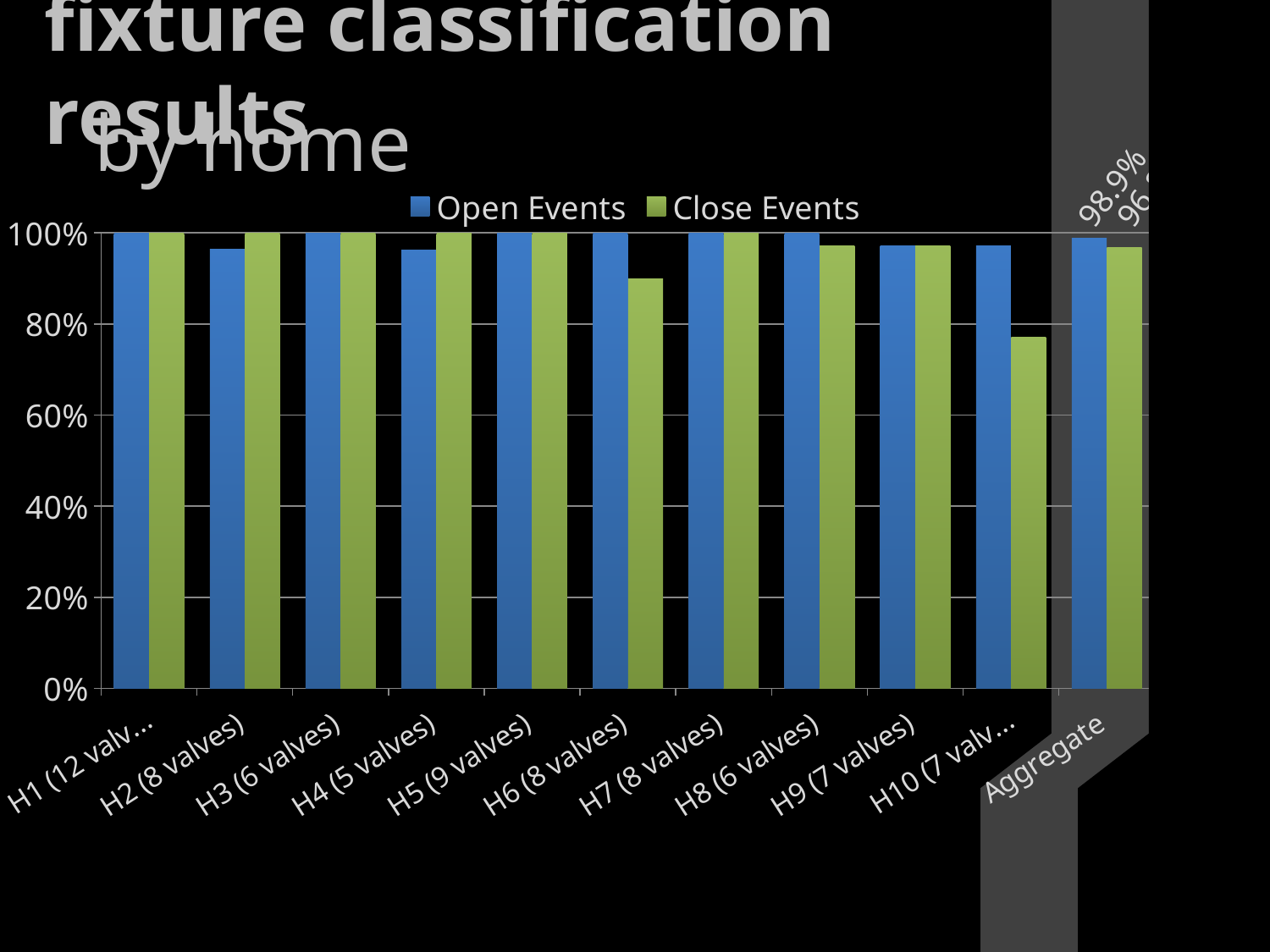
What is the Open Events value for H3 (6 valves)? 100% Is the Close Events value for H6 (8 valves) greater or less than 80%? greater For H6 (8 valves), which is larger: Open Events or Close Events? Open Events What kind of chart is shown on the slide? bar chart How many categories are shown along the x axis? 11 What is the Open Events value for Aggregate? 98.9% Which category has the lowest Close Events value? H10 (7 valv...) What colour are the Open Events bars? blue Is the Close Events value for H10 greater or less than 80%? less Is the Close Events value for H10 greater or less than 60%? greater How many series does the legend list? 2 For H2 (8 valves), which is larger: Open Events or Close Events? Close Events